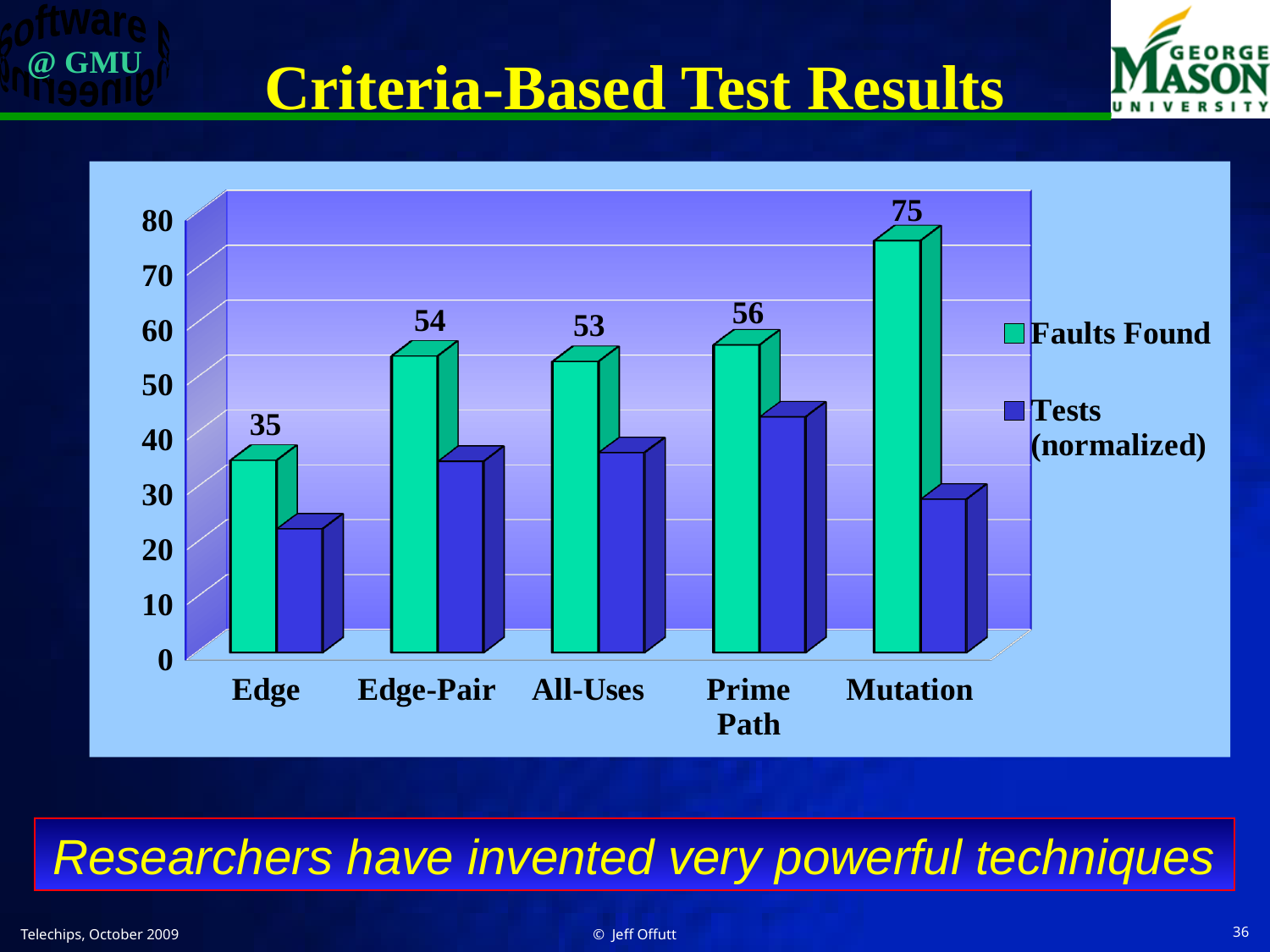
What is the difference in Faults Found between Mutation and Edge? 40 Which has a higher Faults Found value, Prime Path or All-Uses? Prime Path How many series does the legend list? 2 Which criterion has the highest Faults Found value? Mutation Is the Tests (normalized) value for Mutation greater or less than 40? less What is the Faults Found value for Edge? 35 What is the Faults Found value for Prime Path? 56 What kind of chart is shown on the slide? Bar chart Which criterion has the lowest Faults Found value? Edge Is the Tests (normalized) value for Edge greater or less than 30? less What is the Faults Found value for Mutation? 75 How many criteria are shown on the x axis? 5